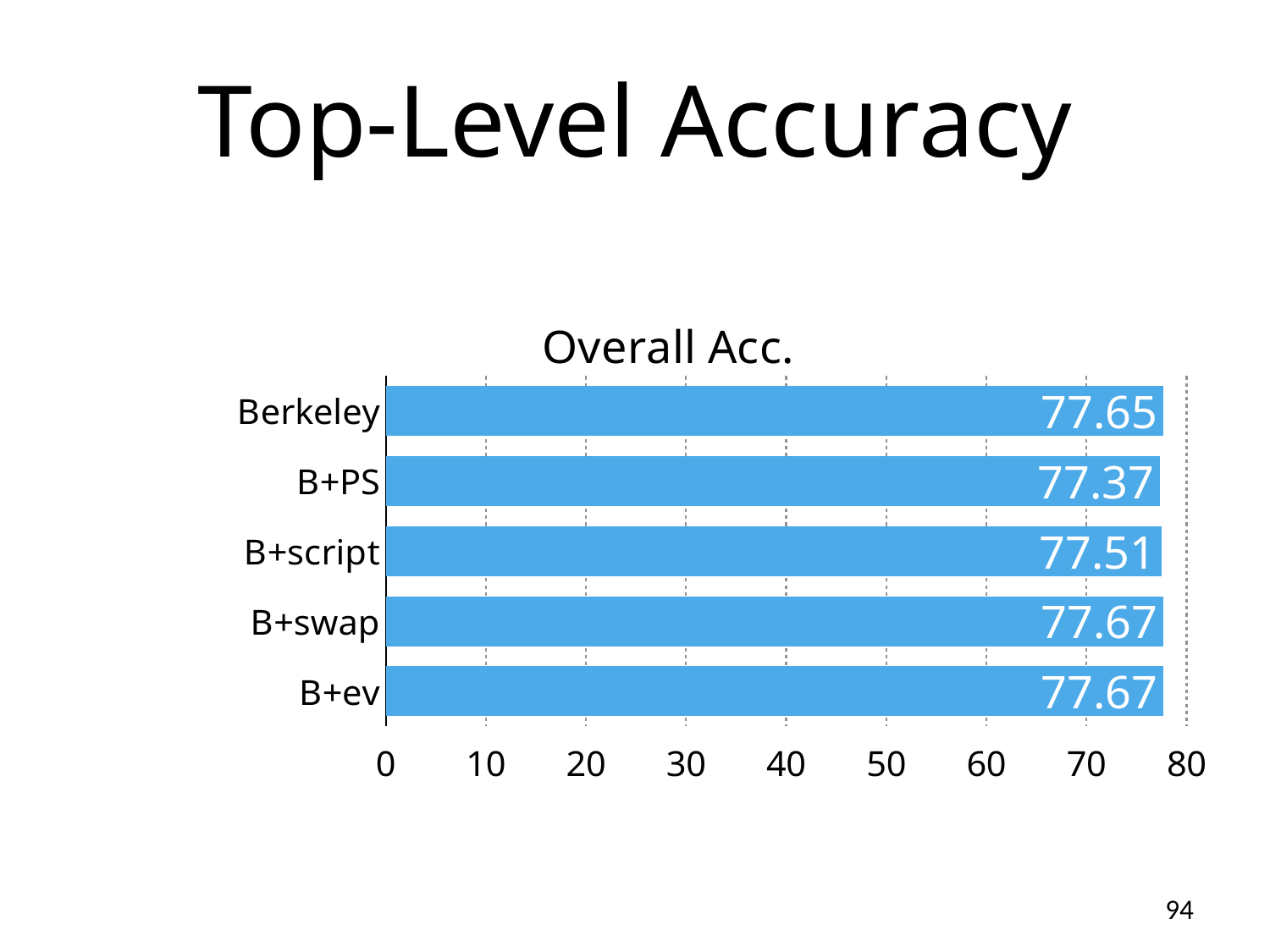
How many categories are shown in the chart? 5 What is the Overall Acc. value for B+ev? 77.67 Is the Overall Acc. value for B+PS greater or less than 70? greater Which category has the lowest Overall Acc. value? B+PS What is the Overall Acc. value for B+PS? 77.37 What is the Overall Acc. value for B+script? 77.51 What is the Overall Acc. value for Berkeley? 77.65 What kind of chart is shown on the slide? bar chart What is the difference between the Overall Acc. values for B+swap and B+PS? 0.30 What is the difference between the Overall Acc. values for Berkeley and B+script? 0.14 What is the title of the chart? Overall Acc. What is the Overall Acc. value for B+swap? 77.67